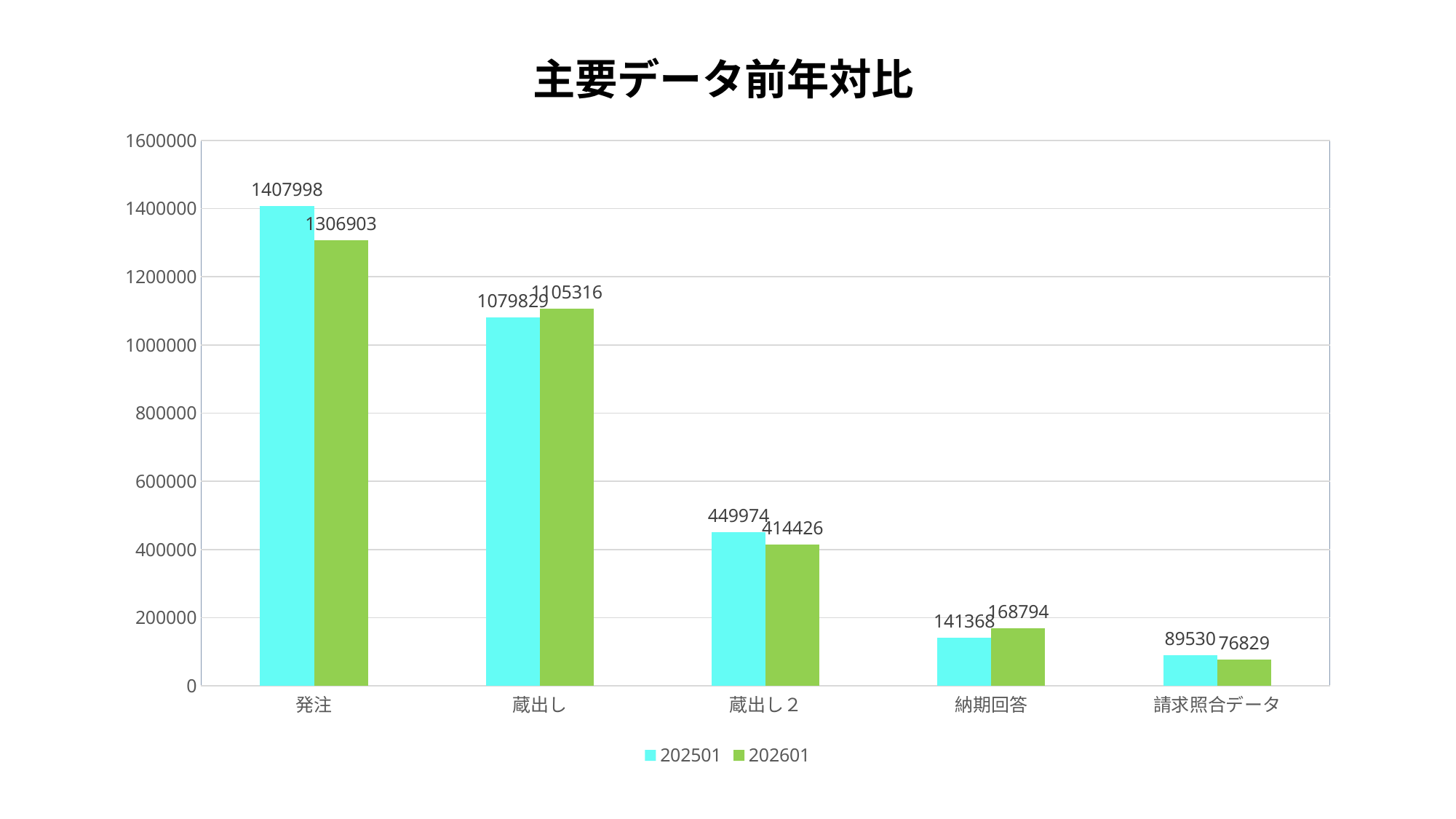
What is the value for 蔵出し in the 202601 series? 1105316 What is the title of the chart? 主要データ前年対比 How many series does the legend list? 2 Which category has the lowest value in the 202601 series? 請求照合データ What is the value for 請求照合データ in the 202601 series? 76829 Which category has the highest value in the 202501 series? 発注 How many categories are shown on the x axis? 5 What is the value for 発注 in the 202501 series? 1407998 For 蔵出し２, which series has the larger value, 202501 or 202601? 202501 What kind of chart is shown on the slide? bar chart What is the difference between the 202601 and 202501 values for 納期回答? 27426 What is the difference between the 202501 and 202601 values for 発注? 101095